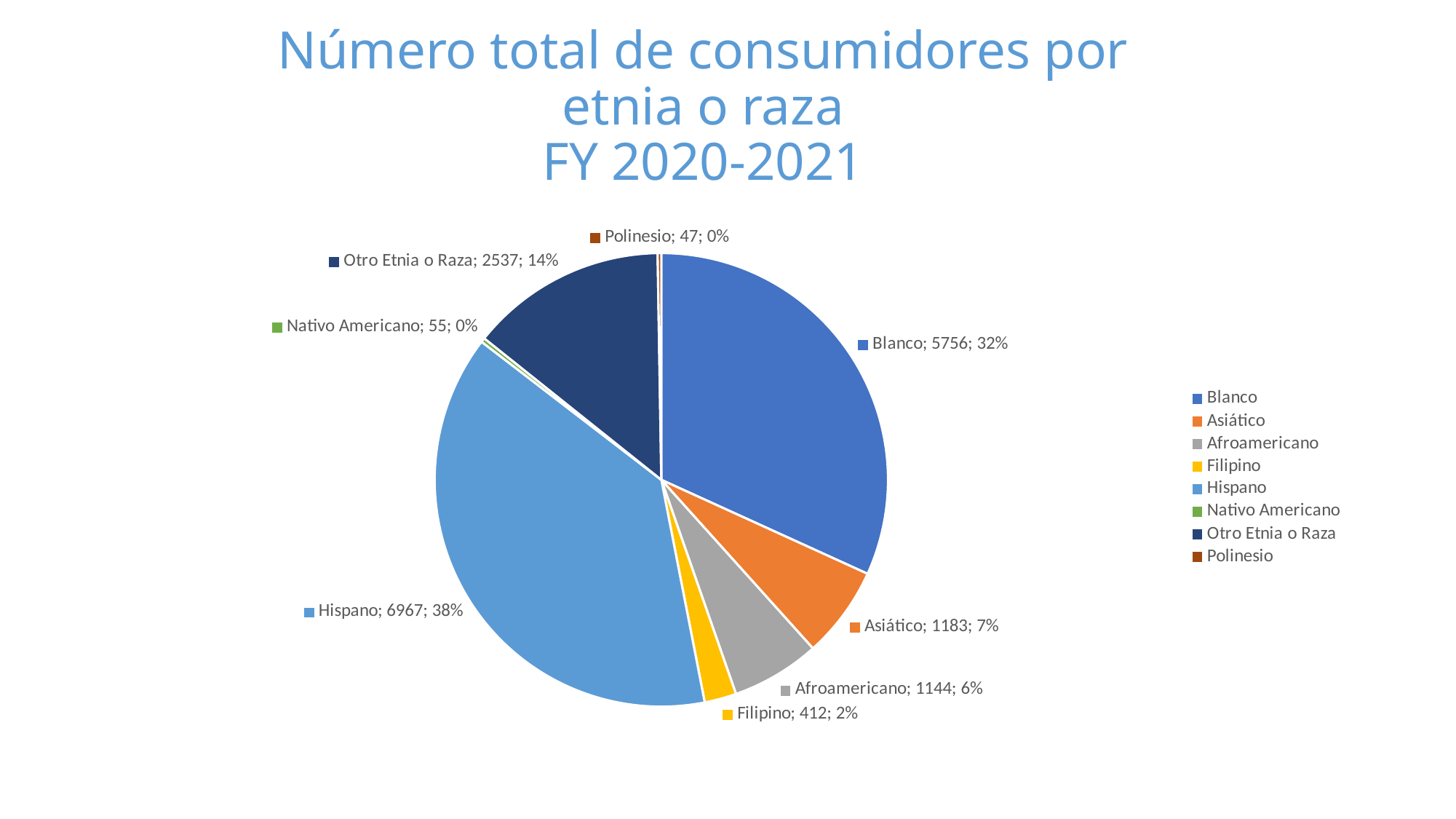
Which category has the smallest number of consumers? Polinesio Which is larger, Asiático or Afroamericano? Asiático How many categories does the pie chart have? 8 What is the difference between the Nativo Americano and Polinesio values? 8 How many consumers are in the Hispano category? 6967 What type of chart is shown on the slide? pie chart What share of the pie does Asiático represent? 7% What percentage share does Otro Etnia o Raza have? 14% What is the title of the chart? Número total de consumidores por etnia o raza FY 2020-2021 Which category has the largest number of consumers? Hispano What is the difference between the Hispano and Blanco values? 1211 What is the value for Blanco? 5756